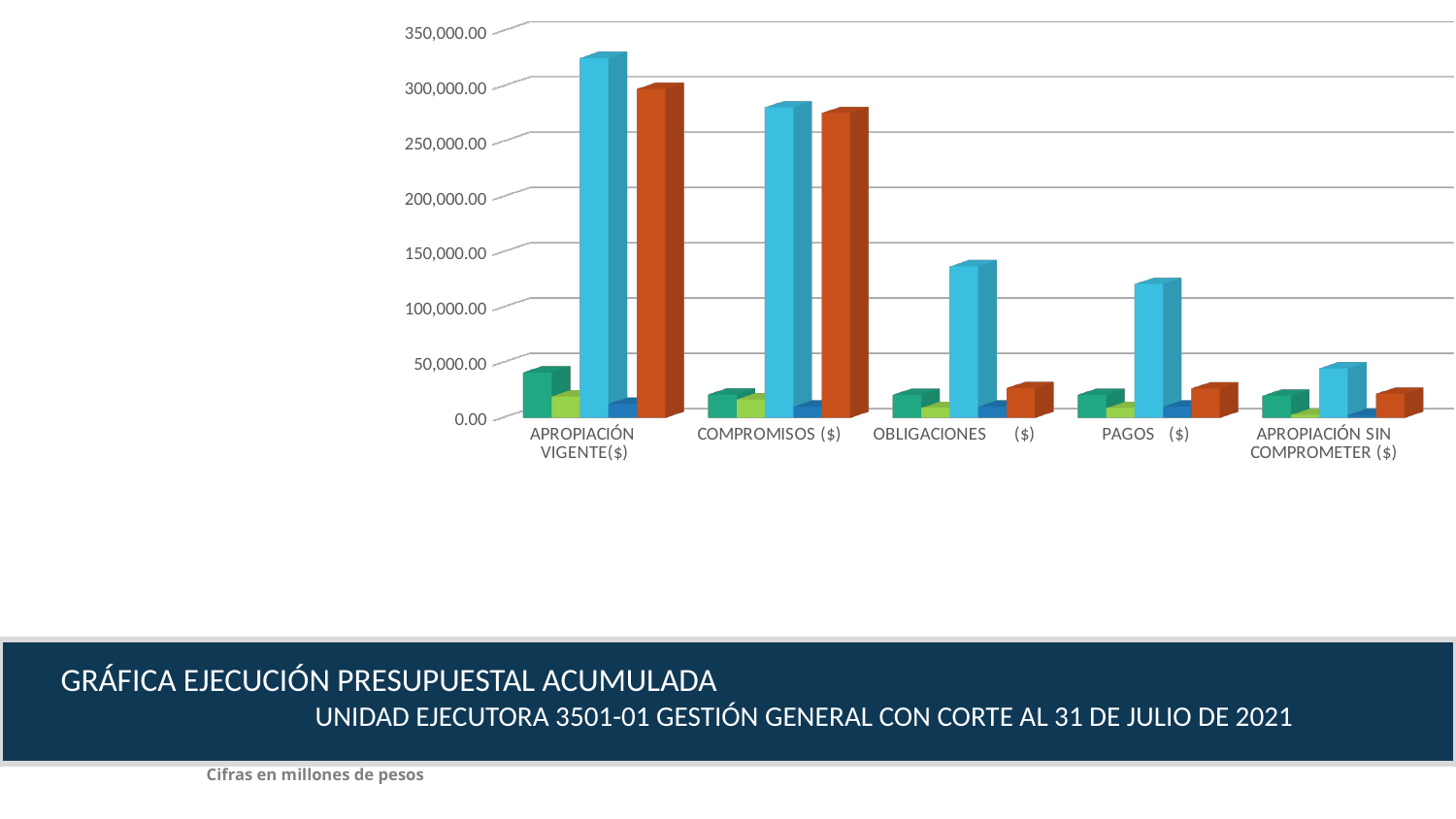
Is the value of the tall light-blue bar for APROPIACIÓN VIGENTE($) greater or less than 300,000.00? greater What is the highest value shown on the chart's vertical axis? 350,000.00 Which category has the tallest light-blue bar? APROPIACIÓN VIGENTE($) Is the value of the tall light-blue bar for OBLIGACIONES ($) greater or less than 100,000.00? greater Is the value of the tall light-blue bar for COMPROMISOS ($) greater or less than 300,000.00? less Which category has the shortest light-blue bar? APROPIACIÓN SIN COMPROMETER ($) How many bars are plotted for each category in the chart? 5 Is the light-blue bar larger for OBLIGACIONES ($) or for PAGOS ($)? OBLIGACIONES ($) What kind of chart is shown on the slide? bar chart How many categories are shown on the x axis of the chart? 5